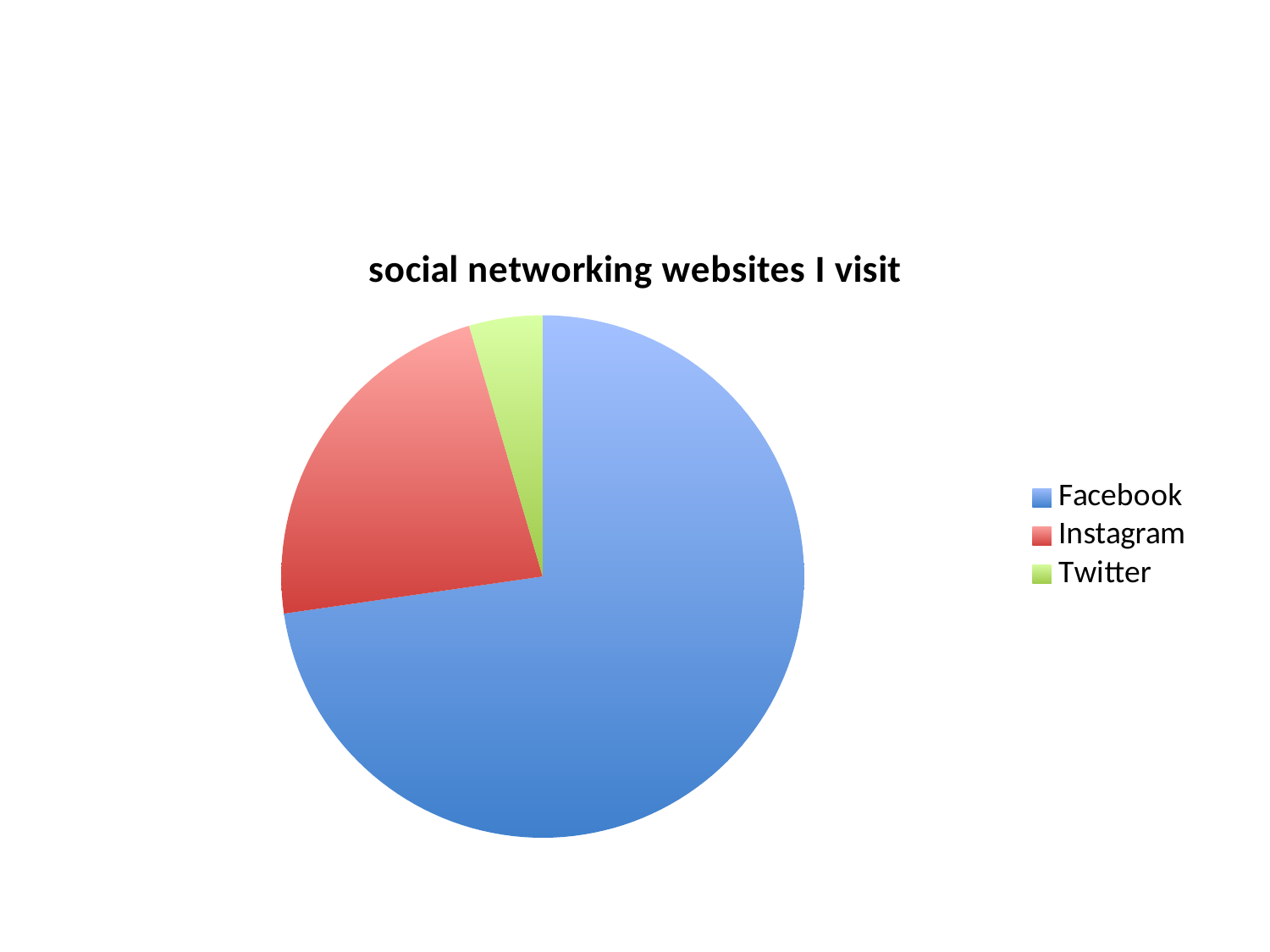
What kind of chart is shown on the slide? pie chart How many entries does the legend list? 3 What is the title of the chart? social networking websites I visit Which slice is larger, Facebook or Instagram? Facebook Which slice is larger, Instagram or Twitter? Instagram Does Facebook account for more or less than half of the pie? more Which category has the smallest slice of the pie? Twitter How many slices does the pie chart have? 3 Which colour represents Twitter in the chart? green Which category has the largest slice of the pie? Facebook